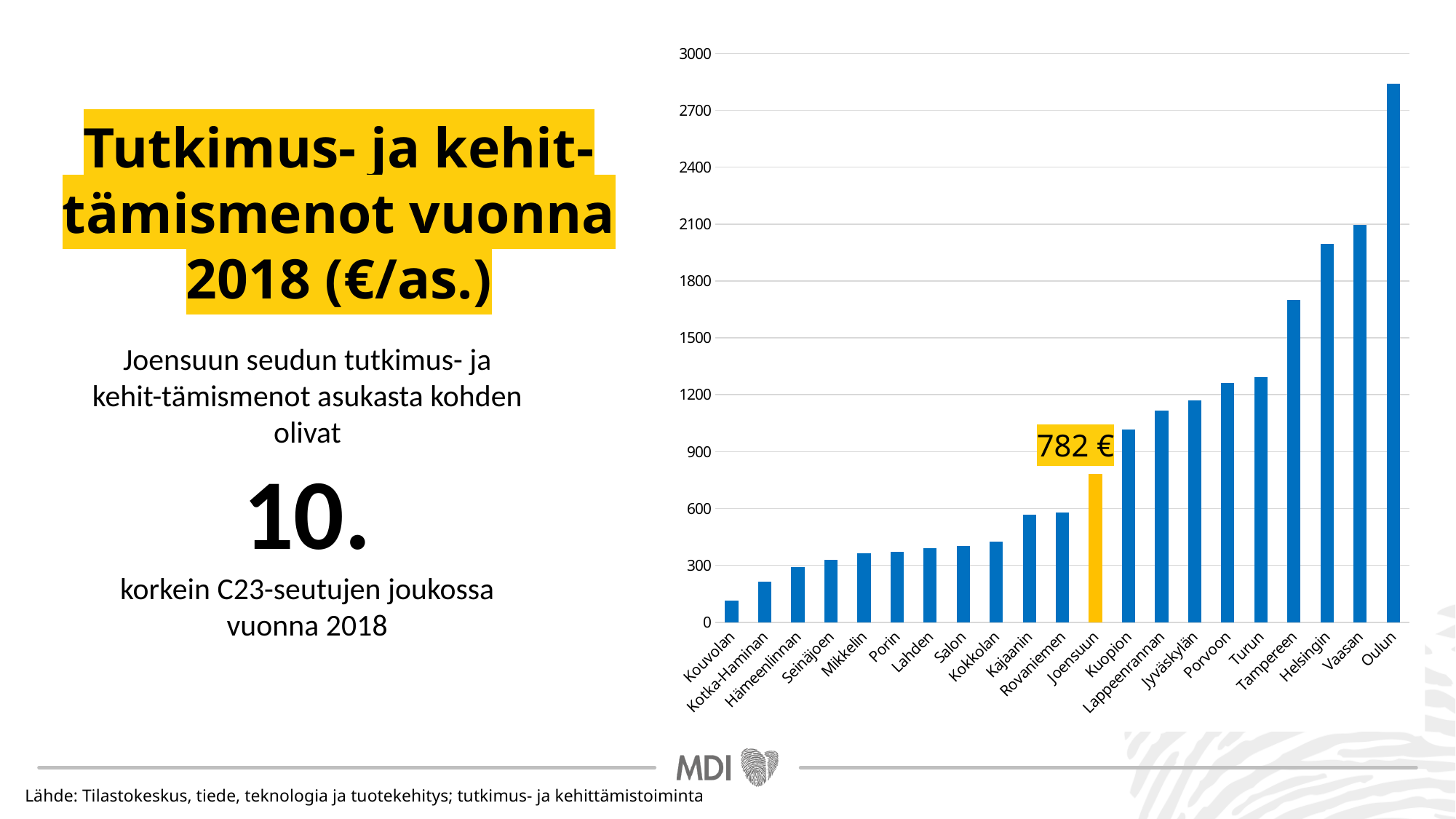
How many regions are shown in the chart? 21 Is the value for Kouvolan greater or less than 300? less Which has a higher value, Kajaanin or Salon? Kajaanin What type of chart is shown on the slide? bar chart Is the value for Tampereen greater or less than 1500? greater What value is labelled for Joensuun in the chart? 782 € Which has a higher value, Helsingin or Vaasan? Vaasan Is the value for Oulun greater or less than 2700? greater Which region has the highest bar in the chart? Oulun Which region has the lowest bar in the chart? Kouvolan Do the bar values rise or fall from left to right along the x axis? rise